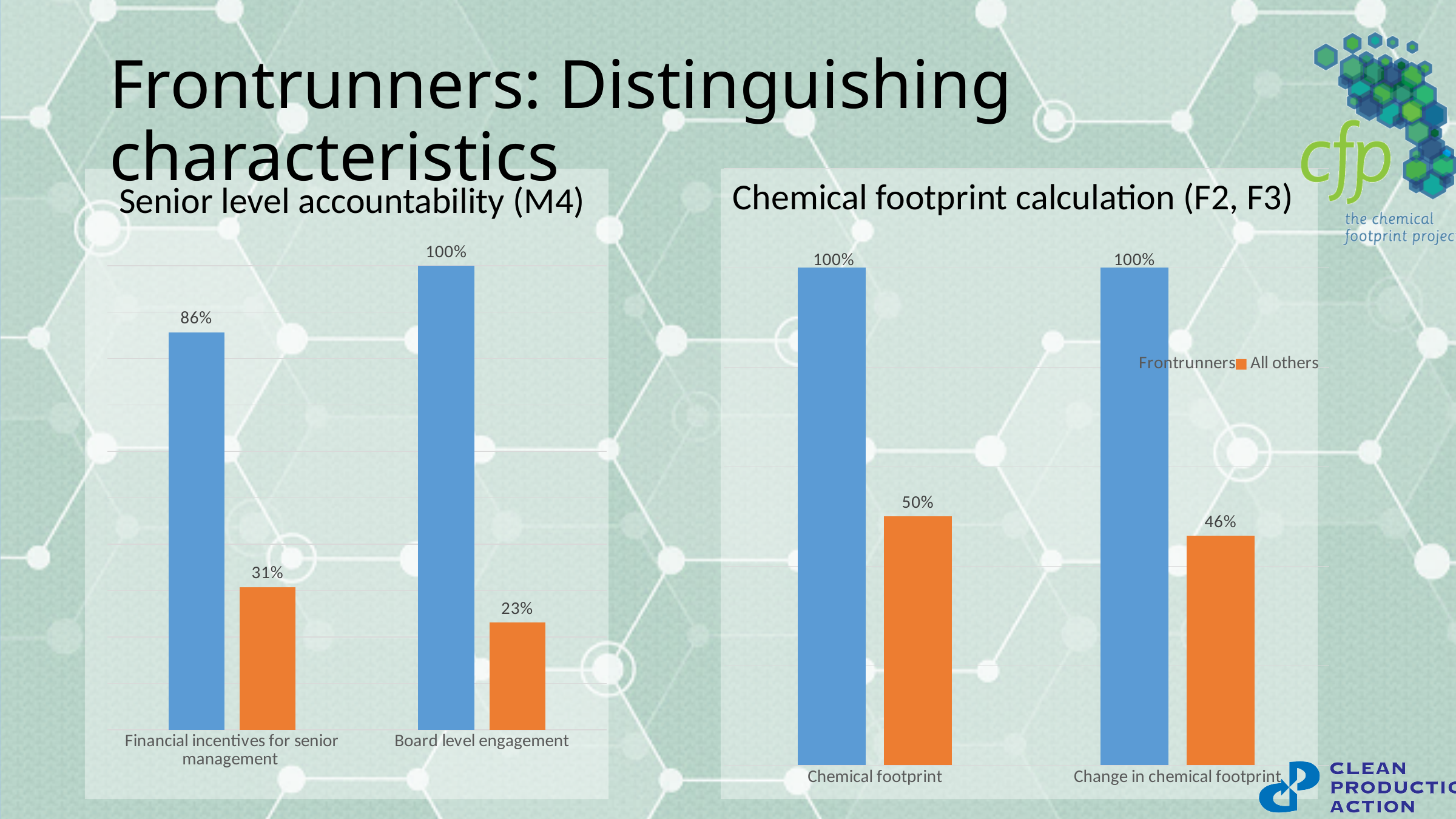
In the 'Chemical footprint calculation (F2, F3)' chart, which is larger for All others: Chemical footprint or Change in chemical footprint? Chemical footprint In the 'Senior level accountability (M4)' chart, what is the difference between the Frontrunners and All others values for Financial incentives for senior management? 55% How many categories are shown in the 'Senior level accountability (M4)' chart? 2 In the 'Chemical footprint calculation (F2, F3)' chart, what is the value for All others for Change in chemical footprint? 46% In the 'Senior level accountability (M4)' chart, which category has the lowest All others value? Board level engagement Which colour represents the All others series in the charts? Orange In the 'Senior level accountability (M4)' chart, what is the value for All others for Board level engagement? 23% In the 'Chemical footprint calculation (F2, F3)' chart, what is the difference between the Frontrunners and All others values for Chemical footprint? 50% In the 'Chemical footprint calculation (F2, F3)' chart, what is the value for All others for Chemical footprint? 50% What kind of chart is the 'Chemical footprint calculation (F2, F3)' chart? Bar chart How many series does the legend on the slide list? 2 In the 'Senior level accountability (M4)' chart, what is the value for Frontrunners for Financial incentives for senior management? 86%